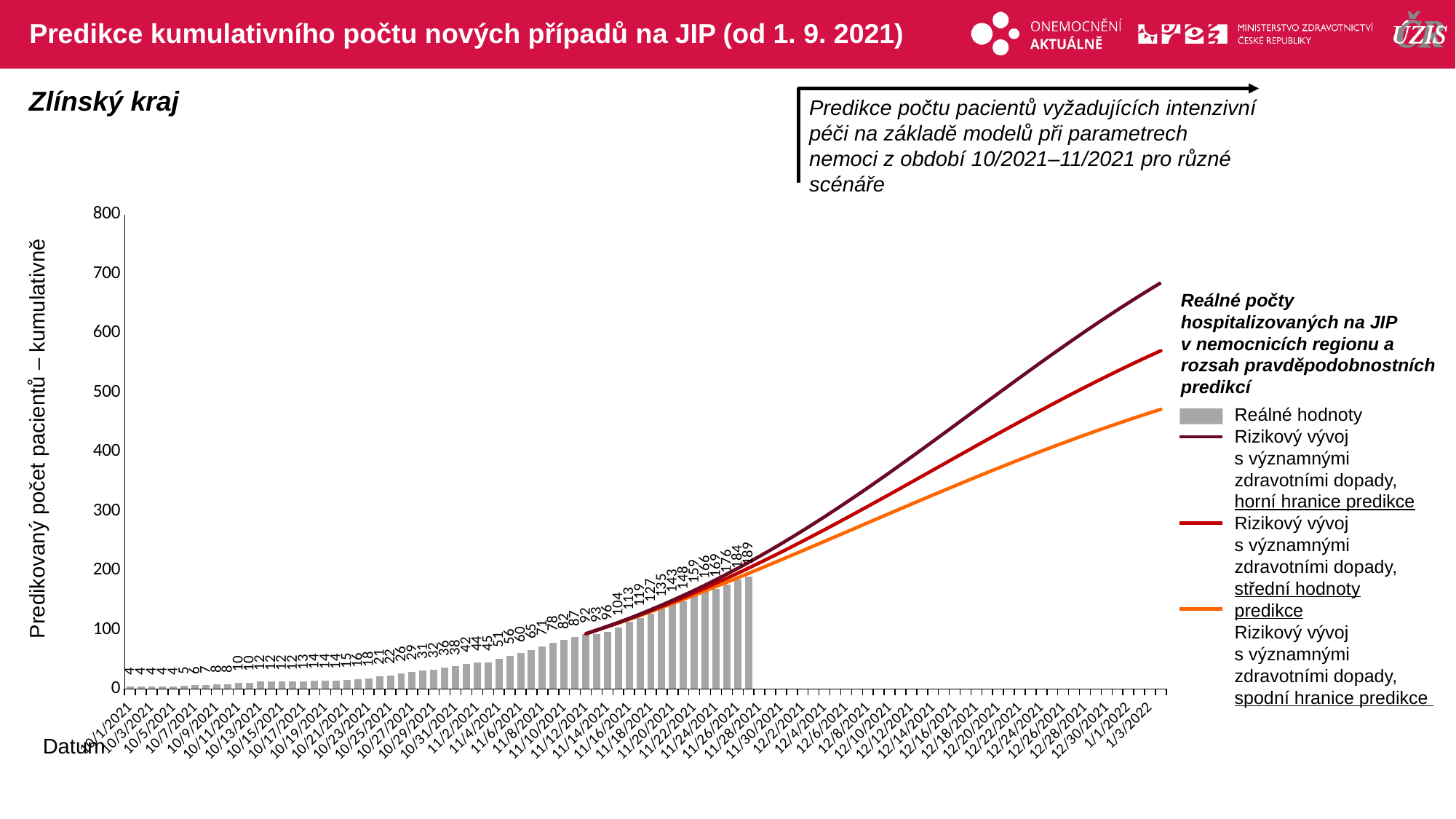
What is the highest labeled value of the real values (Reálné hodnoty) bars? 189 What kind of chart is shown on the slide? bar chart combined with line series How many series does the legend list? 4 What is the lowest labeled value of the real values (Reálné hodnoty) bars? 4 What is the difference between the highest and lowest labeled real values? 185 What is the title of the y axis? Predikovaný počet pacientů – kumulativně Is the middle prediction line (střední hodnoty predikce) at 1/3/2022 greater or less than 500? greater Which region does the chart cover? Zlínský kraj Do the real values rise or fall along the x axis from 10/1/2021 onward? rise Is the lower bound prediction line (spodní hranice predikce) at 1/3/2022 greater or less than 500? less Is the upper bound prediction line (horní hranice predikce) at 1/3/2022 greater or less than 600? greater At 1/3/2022, which prediction line is higher: the upper bound (horní hranice) or the lower bound (spodní hranice)? horní hranice predikce